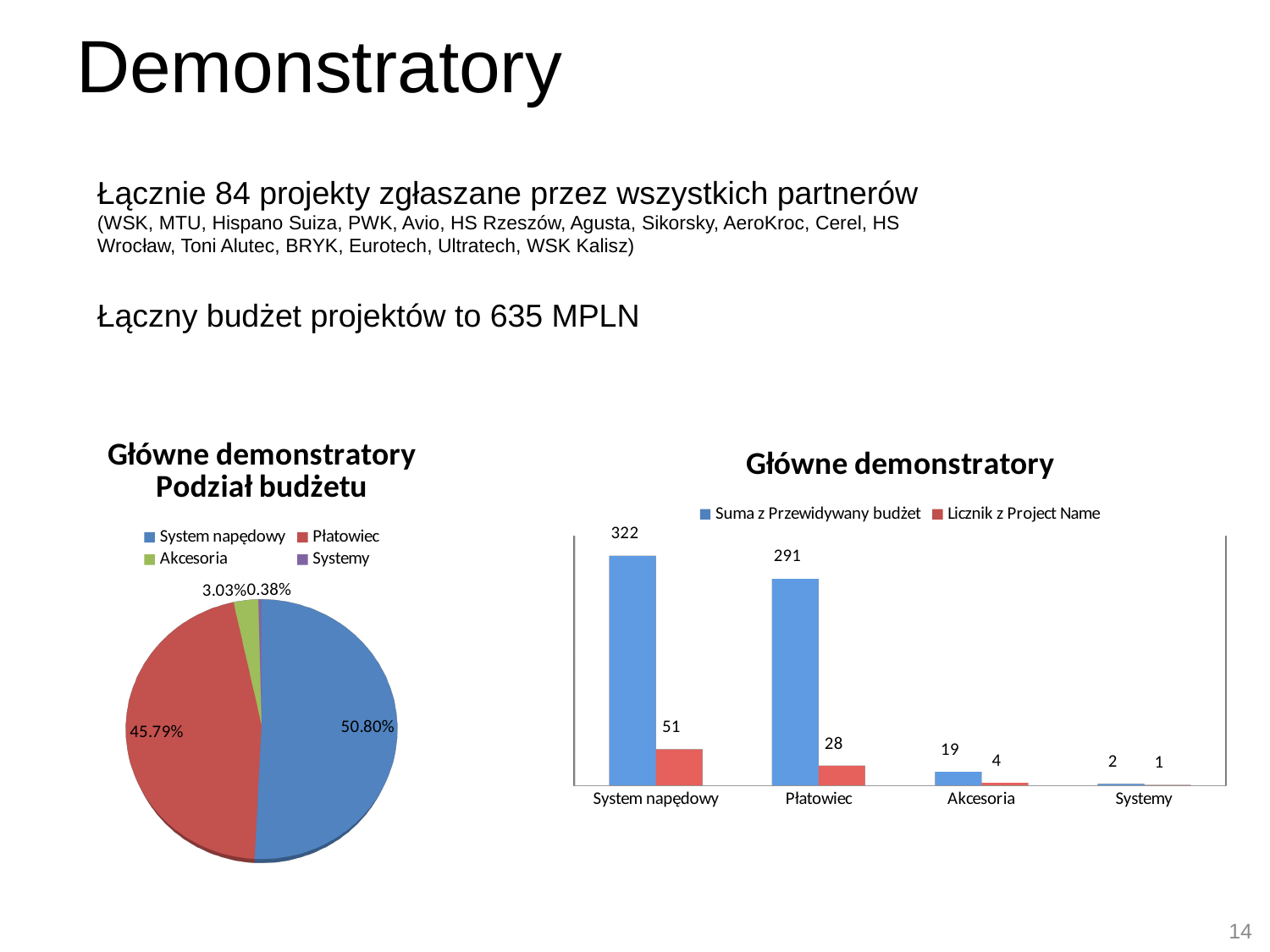
In the bar chart 'Główne demonstratory', what is the value of Licznik z Project Name for Płatowiec? 28 In the pie chart 'Główne demonstratory Podział budżetu', how many categories does the legend list? 4 In the pie chart 'Główne demonstratory Podział budżetu', which category has the smallest slice? Systemy In the pie chart 'Główne demonstratory Podział budżetu', what share does Płatowiec have? 45.79% In the bar chart 'Główne demonstratory', what is the value of Suma z Przewidywany budżet for System napędowy? 322 What type of chart is the chart on the right side of the slide? Bar chart In the bar chart 'Główne demonstratory', what is the difference between Suma z Przewidywany budżet for System napędowy and Płatowiec? 31 In the bar chart 'Główne demonstratory', what is the value of Suma z Przewidywany budżet for Akcesoria? 19 In the bar chart 'Główne demonstratory', how many series does the legend list? 2 In the bar chart 'Główne demonstratory', which is larger: Licznik z Project Name for System napędowy or for Płatowiec? System napędowy In the bar chart 'Główne demonstratory', which category has the highest Suma z Przewidywany budżet? System napędowy In the pie chart 'Główne demonstratory Podział budżetu', what share does System napędowy have? 50.80%